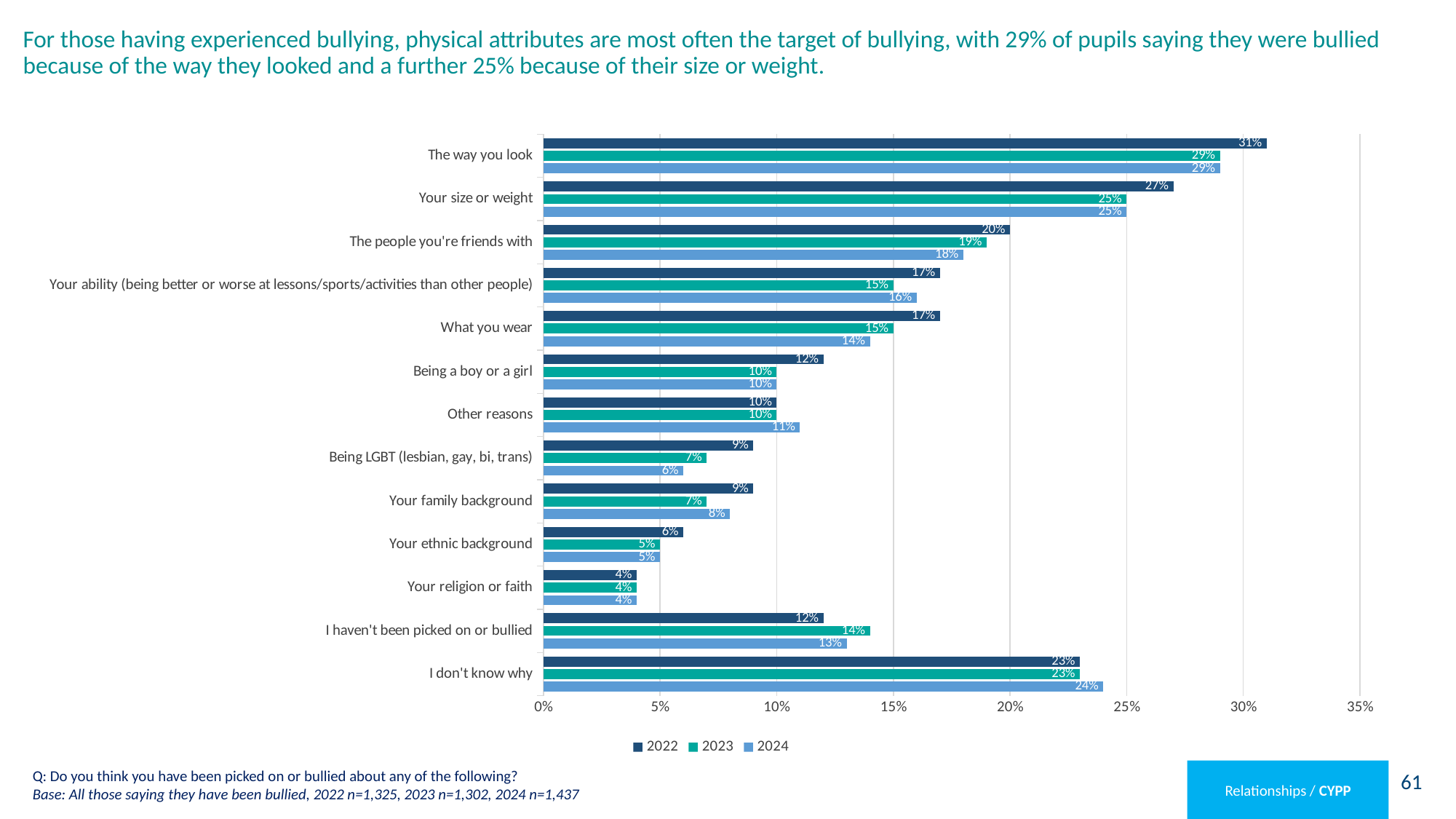
What is the 2024 value for 'The way you look'? 29% How many categories are shown on the chart? 13 How many series does the legend list? 3 Which is larger: the 2024 value for 'Your family background' or the 2024 value for 'Being LGBT (lesbian, gay, bi, trans)'? Your family background What kind of chart is shown on the slide? Bar chart Which category has the lowest 2024 value? Your religion or faith What is the 2024 value for 'I don't know why'? 24% Which year does the darkest blue bar represent according to the legend? 2022 What is the 2023 value for 'I haven't been picked on or bullied'? 14% What is the difference between the 2022 and 2024 values for 'What you wear'? 3% Which category has the highest 2022 value? The way you look What is the 2022 value for 'Your size or weight'? 27%